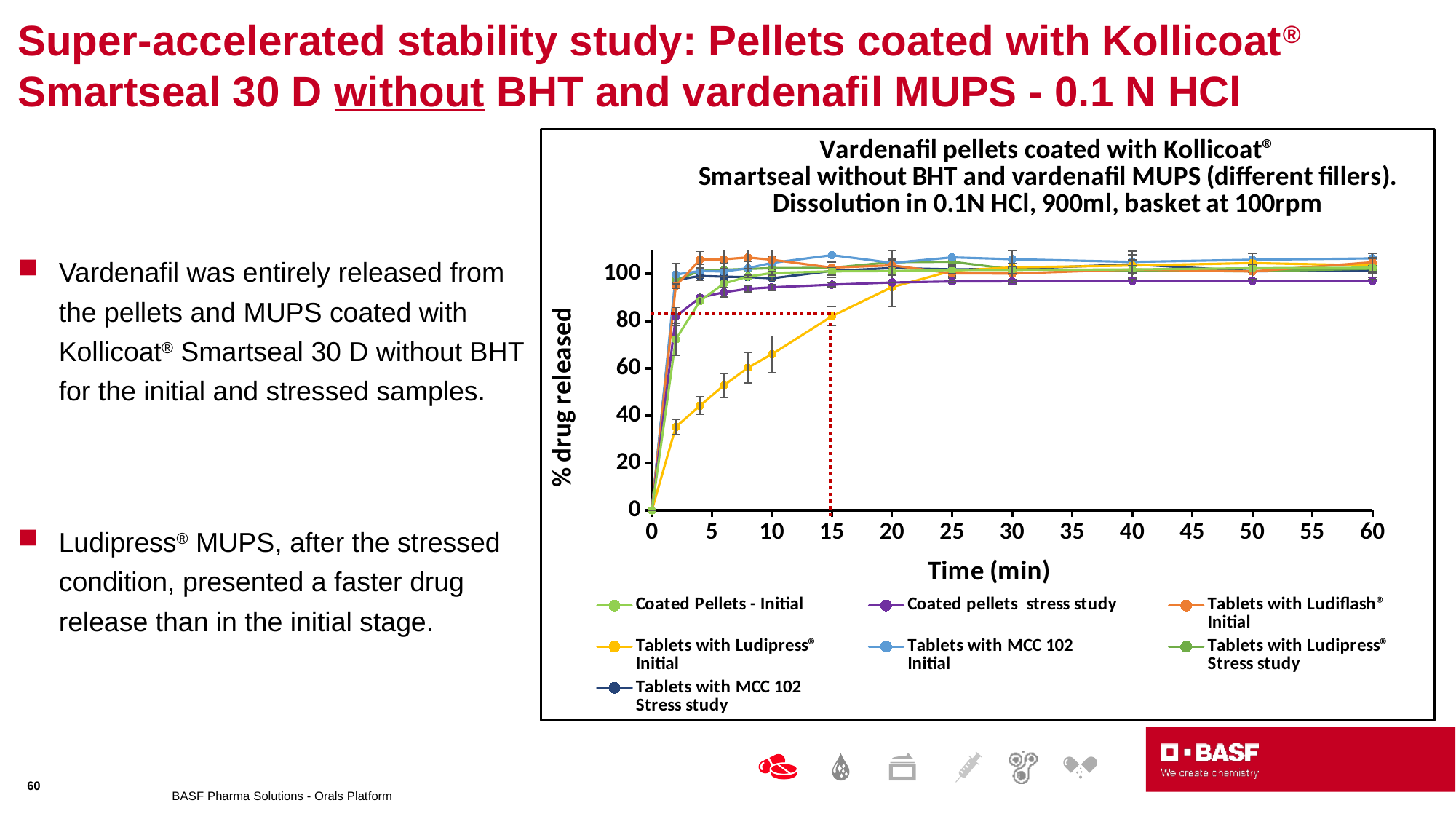
What is the largest time value shown on the x axis? 60 Is the value for Coated pellets stress study at 60 min greater or less than 80? greater What kind of chart is shown on the slide? line chart What is the label of the y axis of the chart? % drug released Does the % drug released for Tablets with Ludipress® Initial rise or fall as time increases from 0 to 60 min? rise Is the value for Tablets with Ludipress® Initial at 15 min greater or less than 60? greater Which series has the lowest % drug released at 10 min? Tablets with Ludipress® Initial Is the value for Tablets with Ludipress® Initial at 10 min greater or less than 80? less At 10 min, which is larger: Coated Pellets - Initial or Tablets with Ludipress® Initial? Coated Pellets - Initial How many series does the chart legend list? 7 What is the label of the x axis of the chart? Time (min) At 10 min, which is larger: Coated pellets stress study or Tablets with Ludipress® Initial? Coated pellets stress study